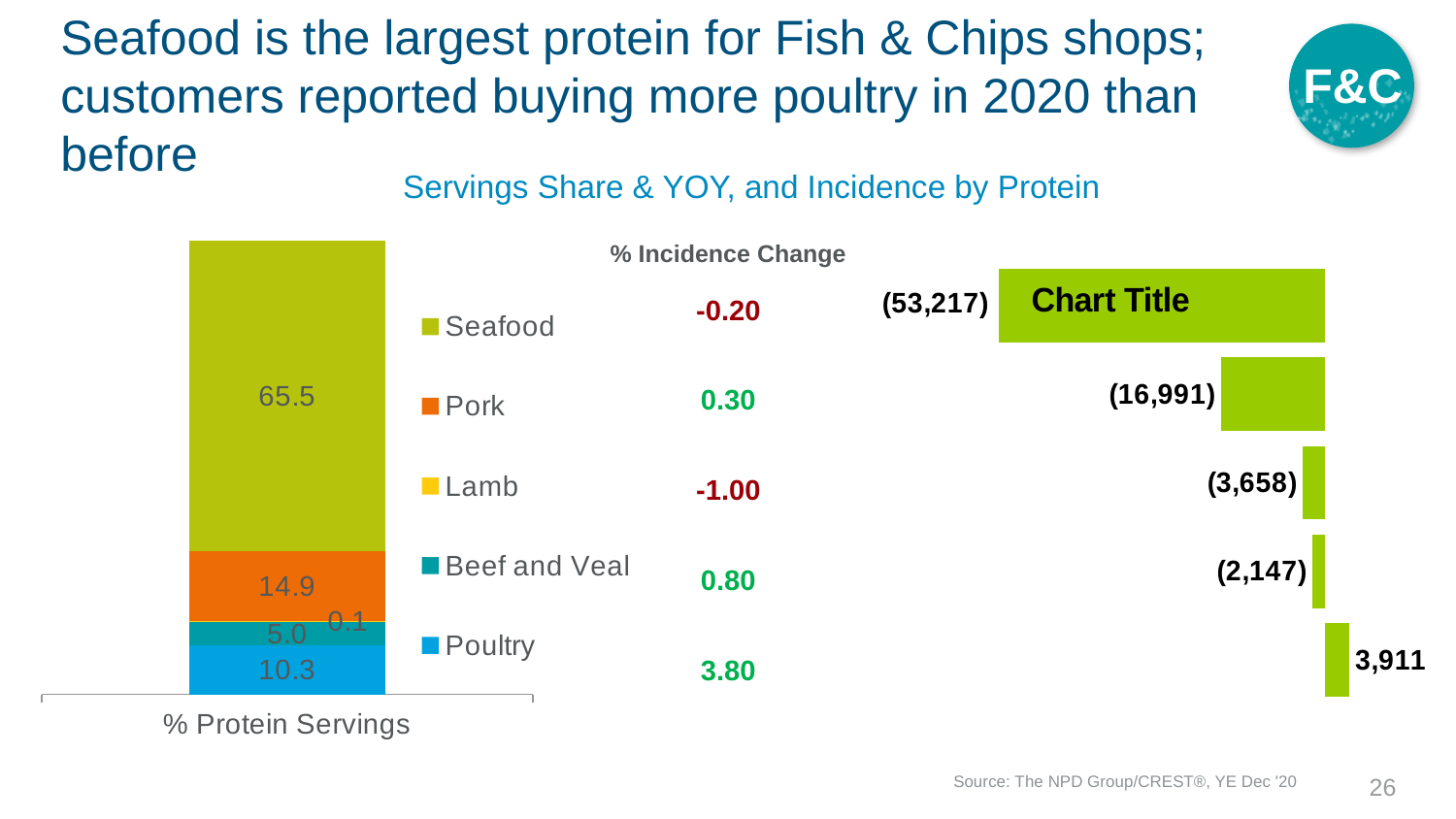
On the left stacked bar chart (% Protein Servings), which protein has the smallest share? Lamb On the left stacked bar chart (% Protein Servings), what is the value for Poultry? 10.3 On the left stacked bar chart (% Protein Servings), what is the value for Beef and Veal? 5.0 On the right-hand bar chart labelled "Chart Title", what is the value of the top bar? (53,217) How many series does the legend of the left stacked bar chart list? 5 What kind of chart is the chart on the left (% Protein Servings)? Stacked bar chart On the right-hand bar chart labelled "Chart Title", what is the value of the bottom bar? 3,911 On the left stacked bar chart (% Protein Servings), which protein has the largest share? Seafood On the left stacked bar chart (% Protein Servings), what is the value for Pork? 14.9 On the left stacked bar chart (% Protein Servings), which is larger, the Poultry value or the Beef and Veal value? Poultry On the left stacked bar chart (% Protein Servings), what is the difference between the Seafood and Pork values? 50.6 On the left stacked bar chart (% Protein Servings), what is the value for Seafood? 65.5